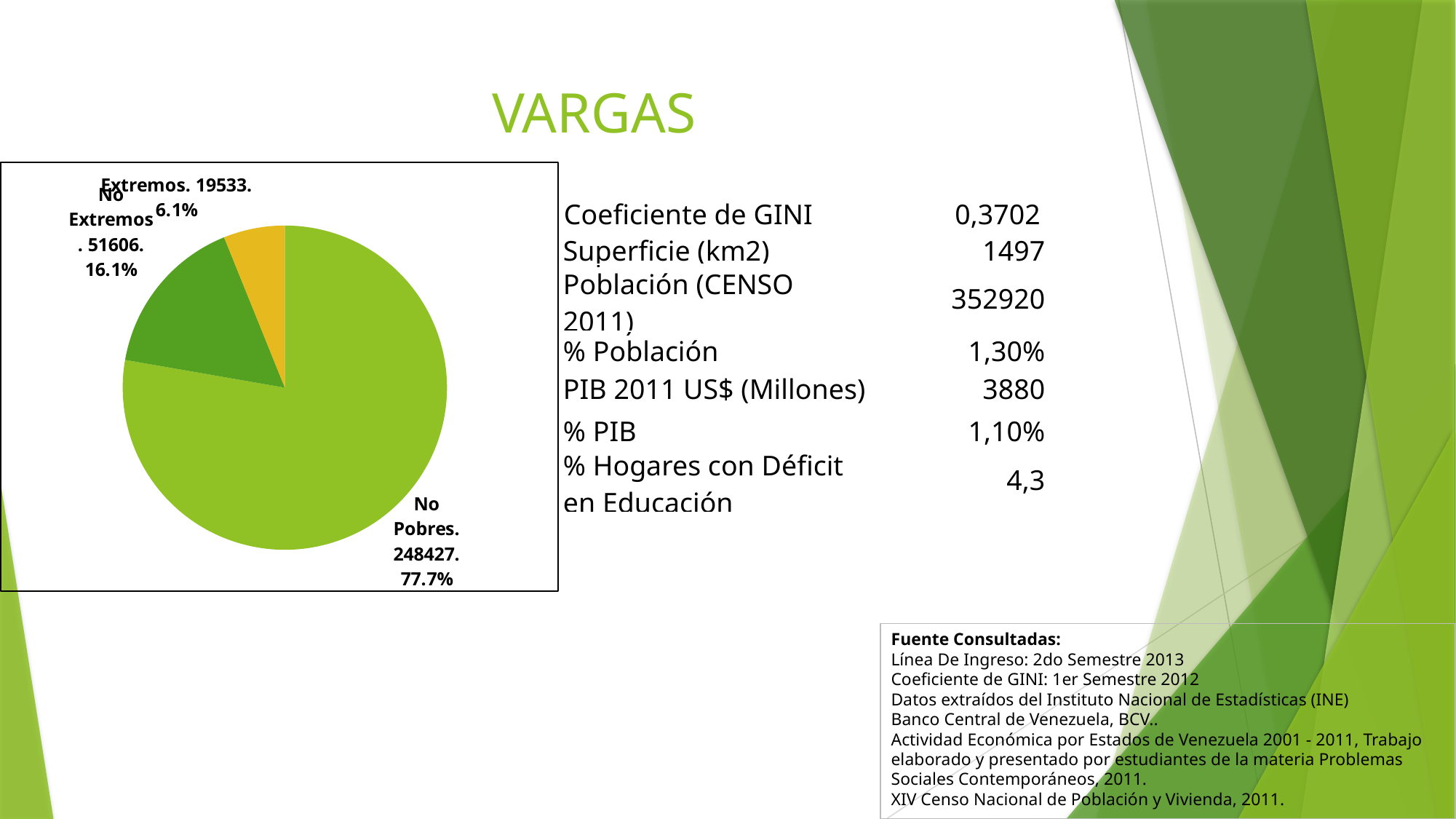
What share of the pie does the No Pobres slice represent? 77.7% Which is larger in the pie chart, No Extremos or Extremos? No Extremos Which slice of the pie chart is the smallest? Extremos Which slice of the pie chart is the largest? No Pobres How many slices does the pie chart have? 3 What is the difference between the No Extremos value and the Extremos value in the pie chart? 32073 What value is shown for the No Extremos slice of the pie chart? 51606 What share of the pie does the No Extremos slice represent? 16.1% What share of the pie does the Extremos slice represent? 6.1% What value is shown for the No Pobres slice of the pie chart? 248427 What kind of chart is shown on the slide? Pie chart What value is shown for the Extremos slice of the pie chart? 19533